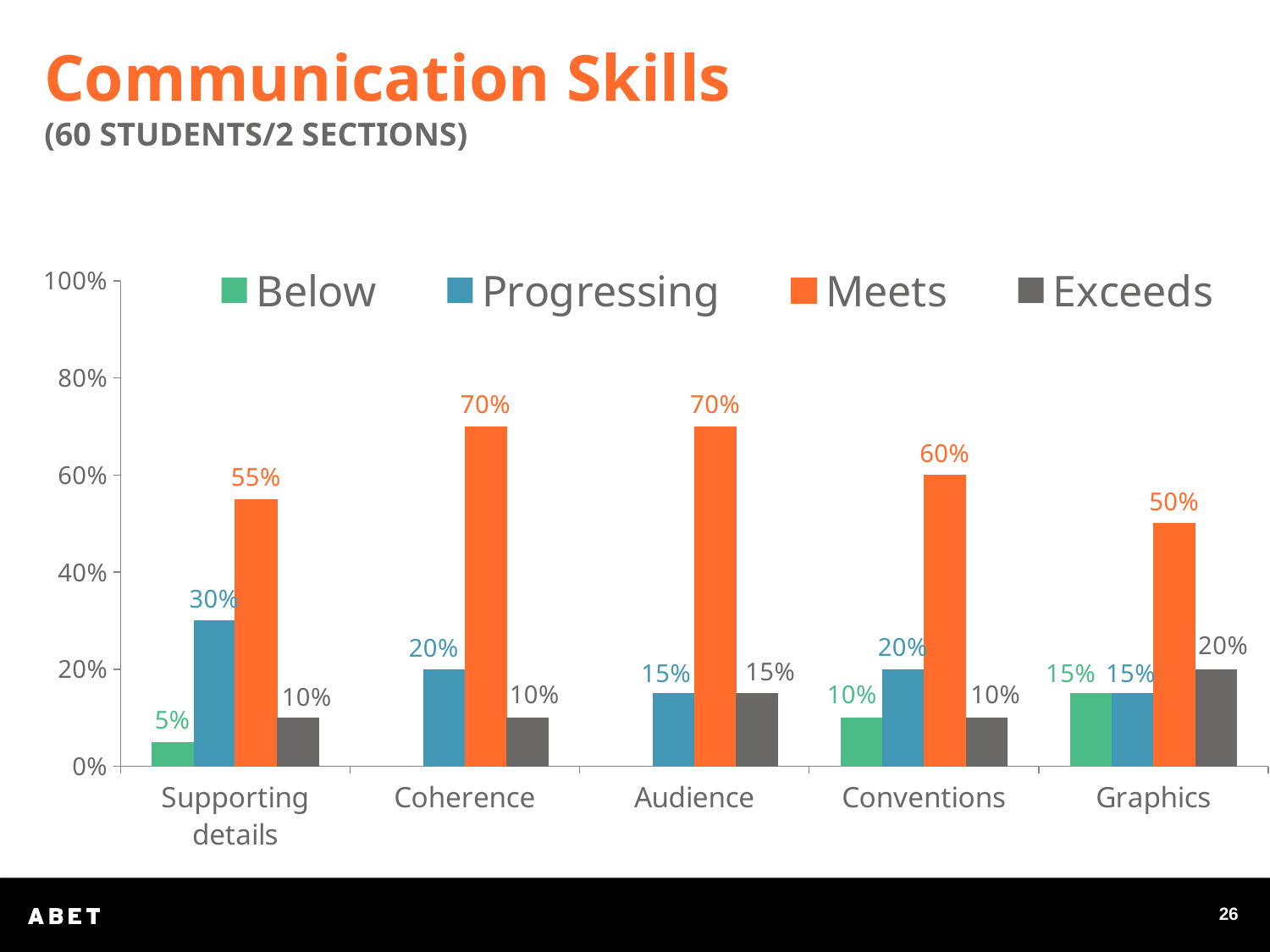
Which is larger, the Exceeds value for Audience or the Exceeds value for Conventions? Audience What kind of chart is shown on the slide? Bar chart What is the Exceeds value for Graphics? 20% Which category has the highest Progressing value? Supporting details How many categories are shown on the x axis? 5 What is the difference between the Meets values for Audience and Graphics? 20% Which series is shown in orange? Meets What is the Meets value for Coherence? 70% Which category has the lowest Meets value? Graphics What is the Progressing value for Supporting details? 30% What is the Below value for Conventions? 10% How many series does the legend list? 4